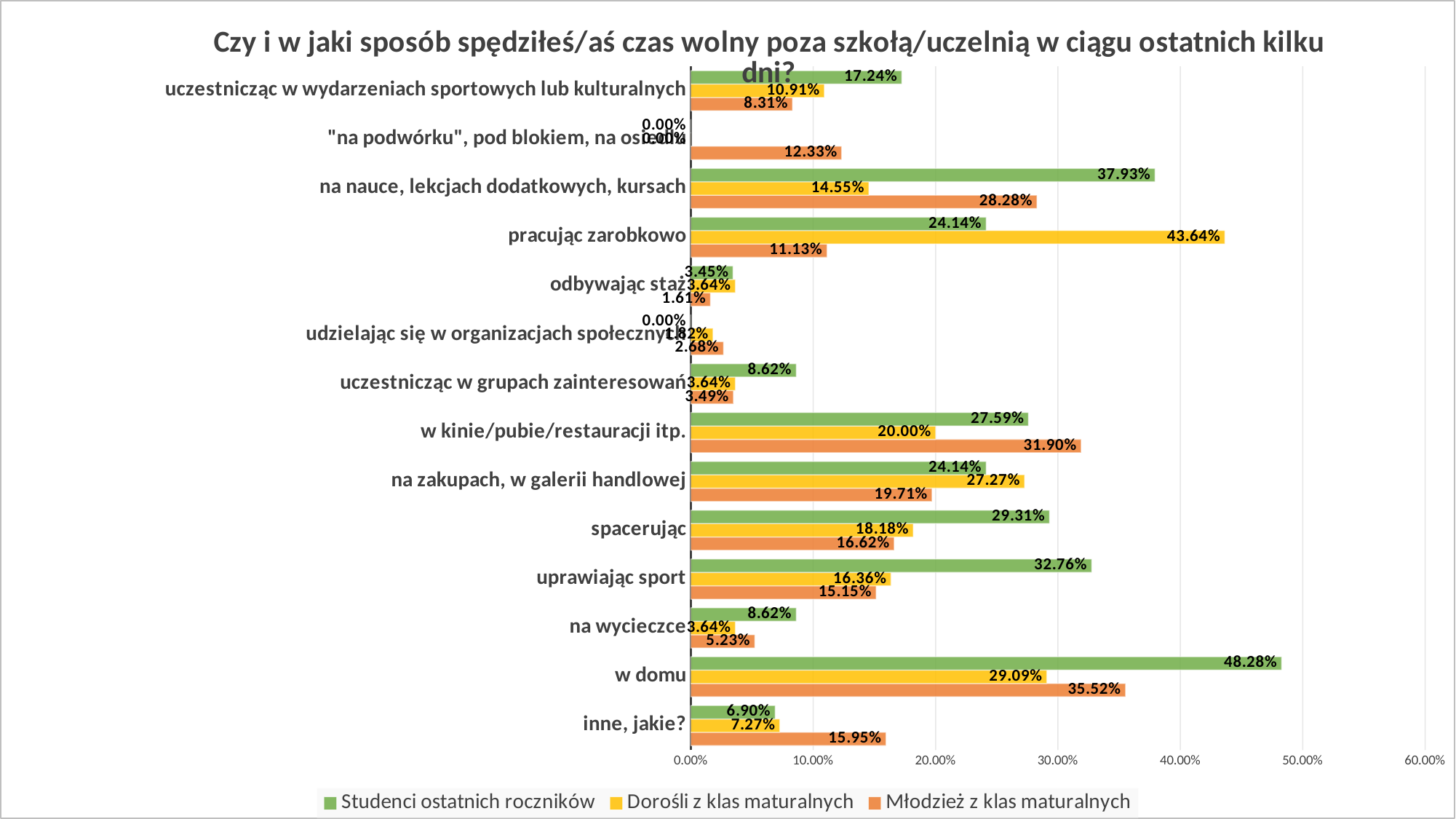
What is the value for 'Dorośli z klas maturalnych' in the category 'pracując zarobkowo'? 43.64% How many categories (ways of spending free time) are shown on the chart? 14 Which colour represents the series 'Dorośli z klas maturalnych'? yellow Which category has the highest value for 'Dorośli z klas maturalnych'? pracując zarobkowo In the category 'na nauce, lekcjach dodatkowych, kursach', which series has the larger value: 'Studenci ostatnich roczników' or 'Młodzież z klas maturalnych'? Studenci ostatnich roczników Which category has the highest value for 'Studenci ostatnich roczników'? w domu What type of chart is shown on the slide? bar chart Which category has the lowest value for 'Młodzież z klas maturalnych'? odbywając staż What is the value for 'Młodzież z klas maturalnych' in the category 'w kinie/pubie/restauracji itp.'? 31.90% What is the value for 'Studenci ostatnich roczników' in the category 'w domu'? 48.28% What is the difference between 'Studenci ostatnich roczników' and 'Młodzież z klas maturalnych' in the category 'w domu'? 12.76% How many series does the legend list? 3